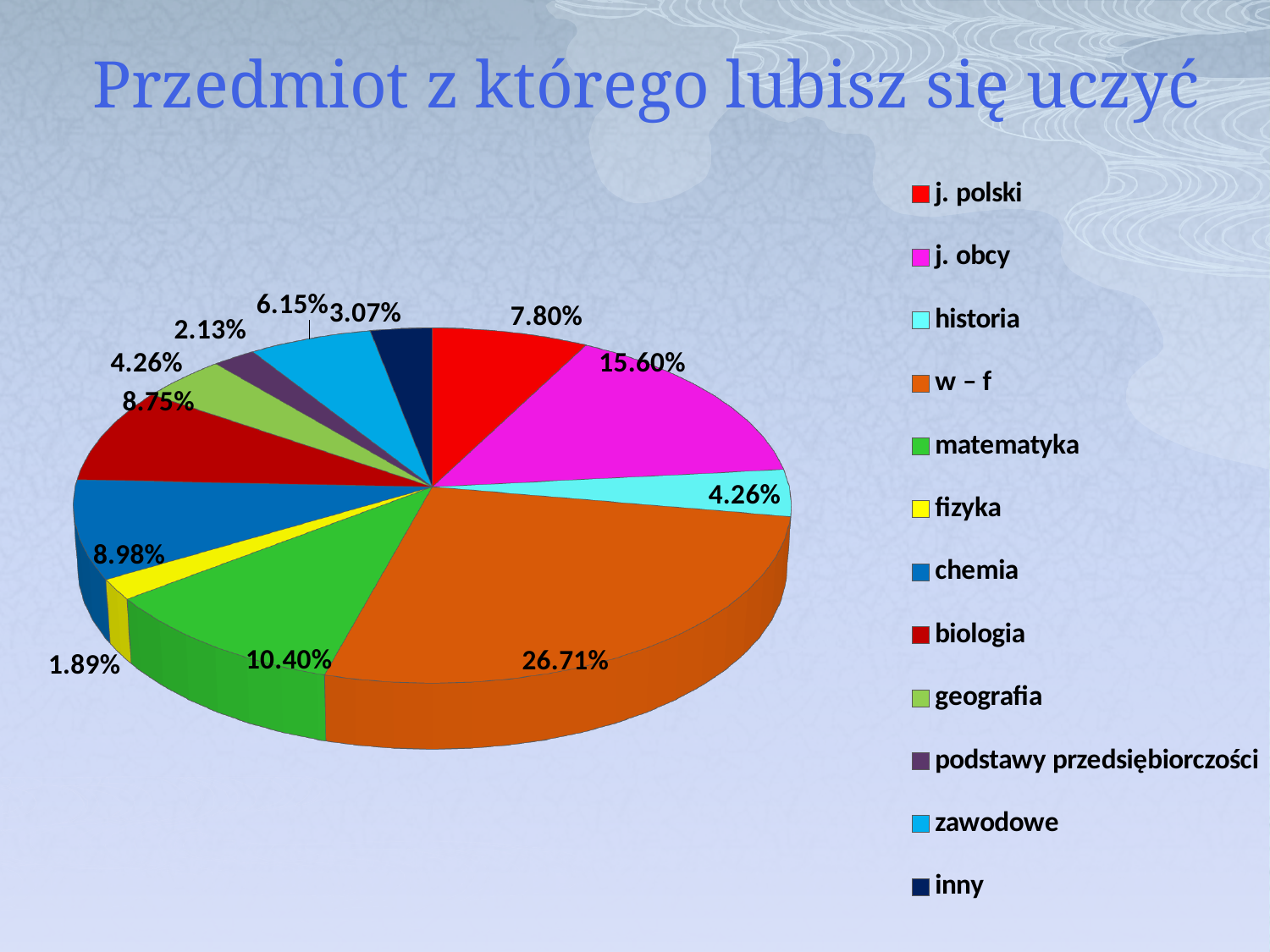
Which category has the largest share of the pie? w – f Which has a larger share, chemia or biologia? chemia What is the difference between the shares of w – f and j. obcy? 11.11% How many categories does the legend list? 12 What percentage is shown for matematyka? 10.40% What percentage is shown for w – f? 26.71% What percentage is shown for fizyka? 1.89% What type of chart is shown on the slide? pie chart What is the title of the chart? Przedmiot z którego lubisz się uczyć Which category has the smallest share of the pie? fizyka What colour represents zawodowe in the chart? light blue What percentage is shown for j. obcy? 15.60%